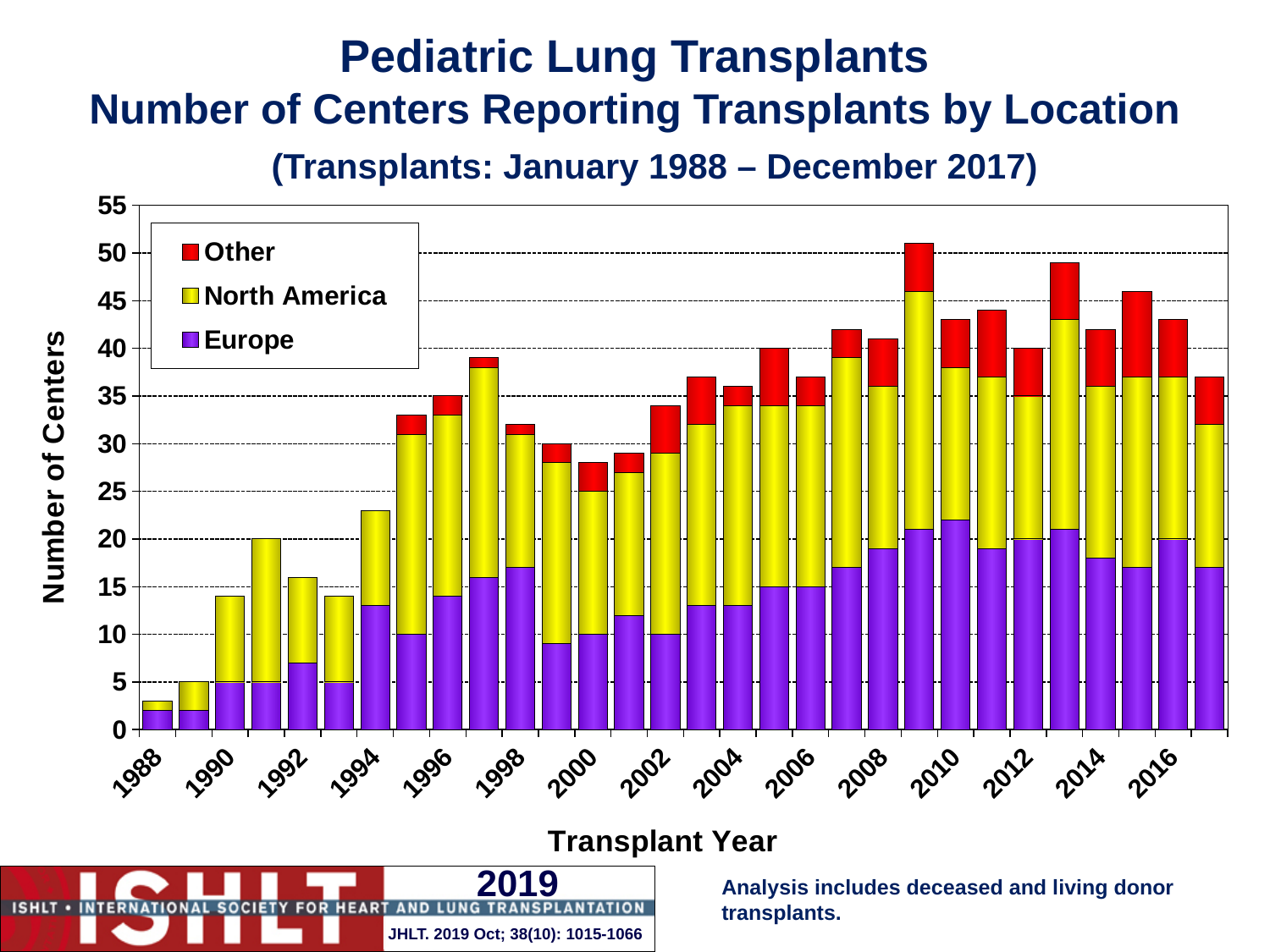
Which transplant year has the lowest total number of centers? 1988 How many series does the legend list? 3 Do the total numbers of centers generally rise or fall from 1988 to 1997? rise Is the number of Europe centers for 1994 greater or less than 10? greater What colour represents Europe in the chart? Purple Is the total number of centers for 2009 greater or less than 50? greater What kind of chart is shown on the slide? Stacked bar chart Which transplant year has the highest total number of centers? 2009 Which series are listed in the legend? Other, North America, Europe Is the total number of centers for 1988 greater or less than 5? less Which year has a larger total number of centers, 1990 or 1995? 1995